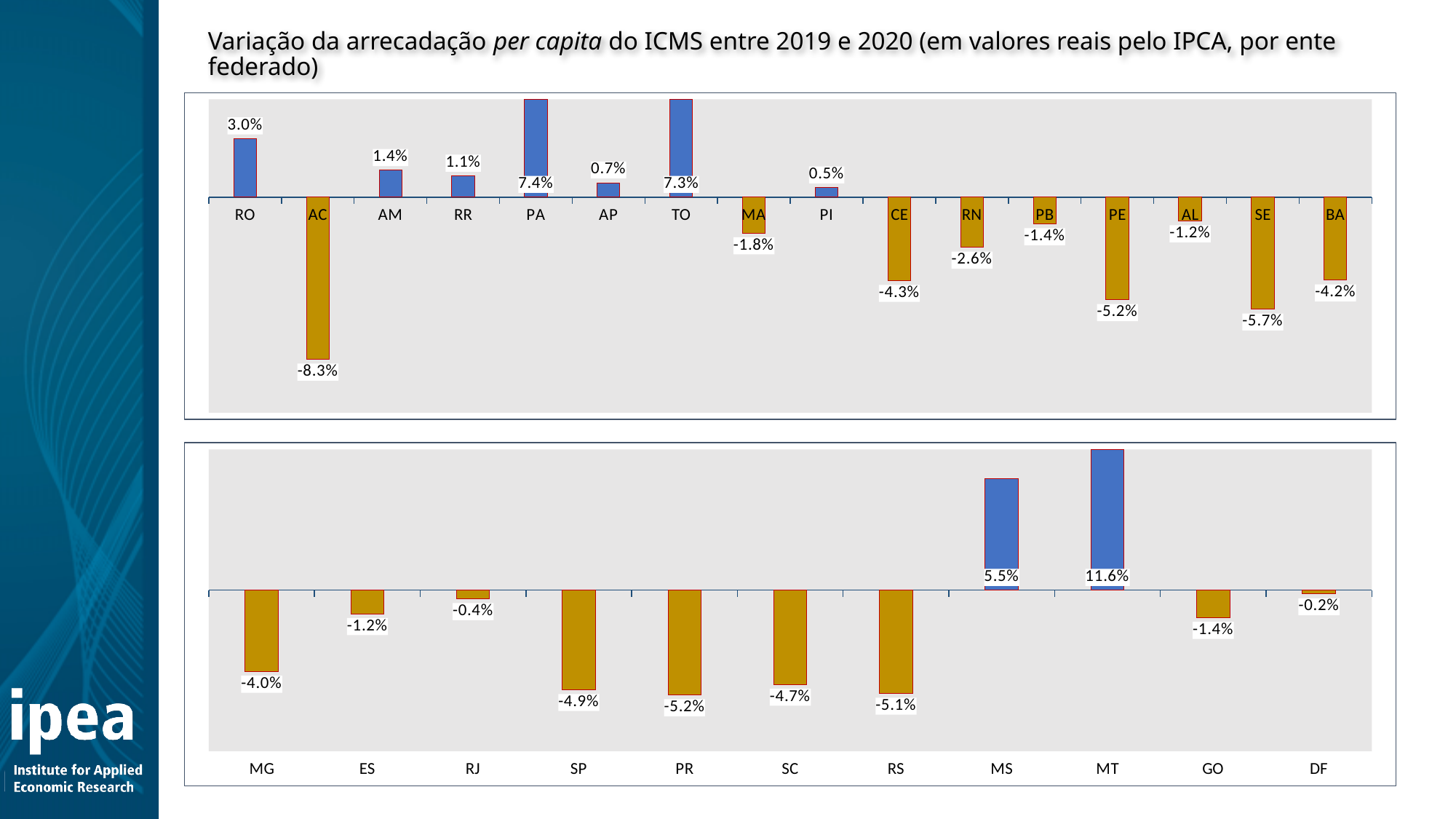
What kind of chart is the bottom chart? Bar chart In the bottom chart, which state has the highest value? MT In the top chart, what is the difference between the values for CE and MA? 2.5 percentage points In the bottom chart, what is the difference between the values for MT and MS? 6.1 percentage points In the bottom chart, what is the value for MT? 11.6% In the bottom chart, what is the value for RJ? -0.4% How many states are shown in the bottom chart? 11 How many states are shown in the top chart? 16 In the top chart, what is the value for SE? -5.7% In the top chart, which is larger, the value for AM or the value for PI? AM In the top chart, what is the value for RO? 3.0% In the top chart, which state has the lowest value? AC